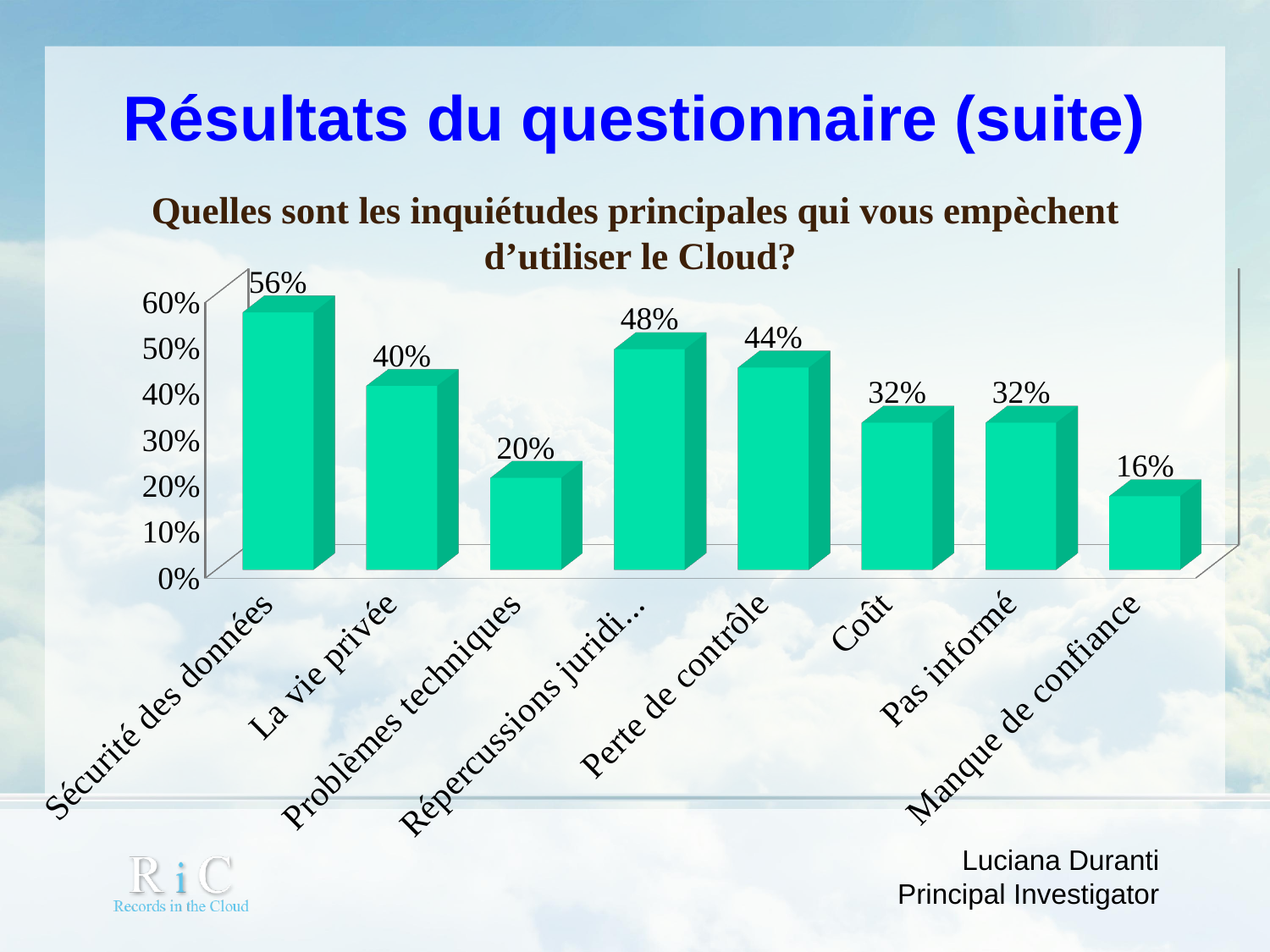
Which category has the lowest value? Manque de confiance What is the value for Manque de confiance? 16% What is the title of the chart? Quelles sont les inquiétudes principales qui vous empèchent d'utiliser le Cloud? Which category has the highest value? Sécurité des données What is the value for Sécurité des données? 56% How many categories are shown on the chart? 8 What kind of chart is shown on the slide? bar chart Which is larger, the value for La vie privée or the value for Problèmes techniques? La vie privée Is the value for Perte de contrôle greater or less than 40%? greater What is the value for Perte de contrôle? 44% What is the difference between the values for Perte de contrôle and Coût? 12% What is the difference between the values for Sécurité des données and La vie privée? 16%